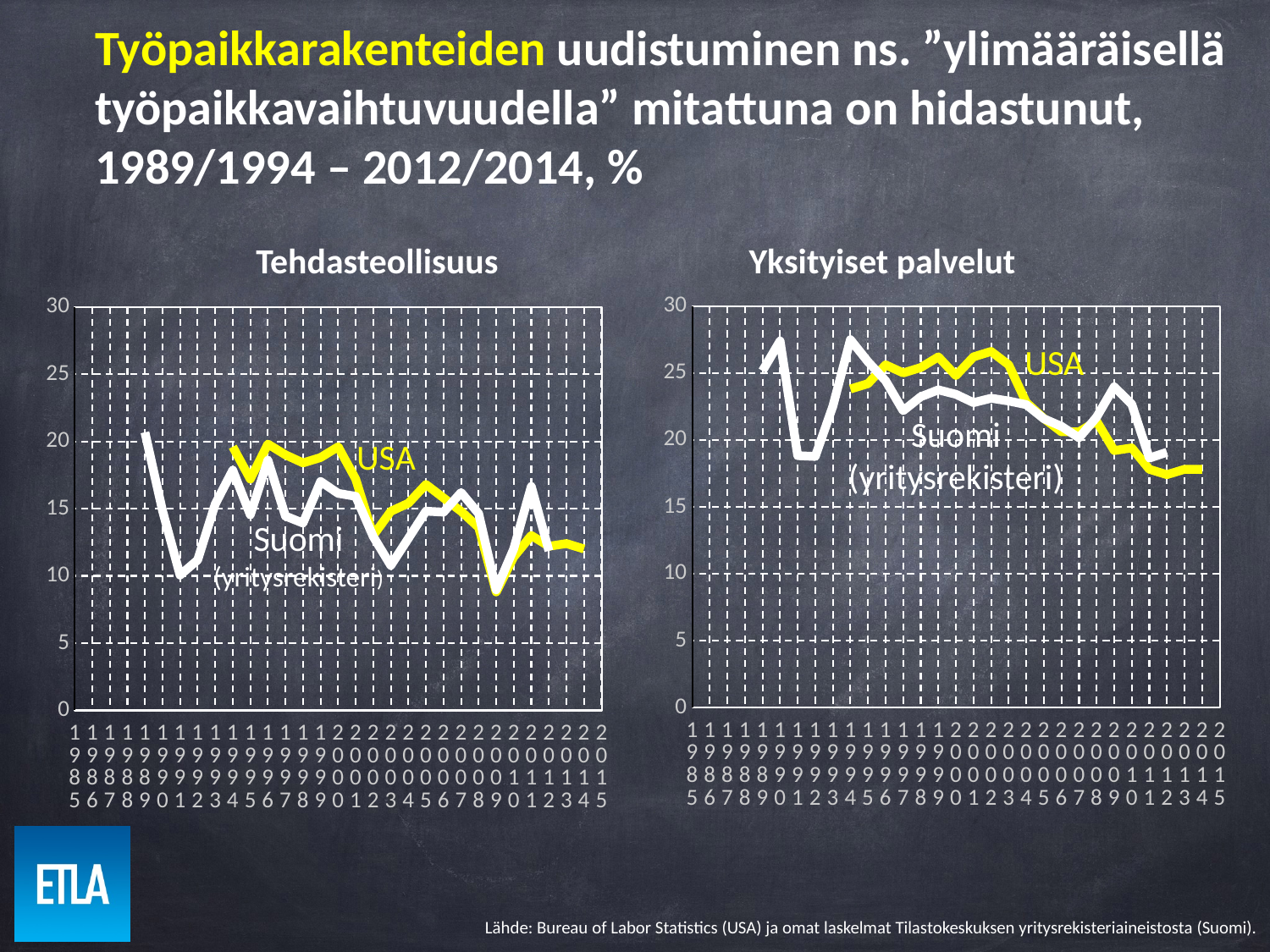
What kind of chart is the Tehdasteollisuus chart? line chart In the Yksityiset palvelut chart, which series is drawn in yellow? USA In the Yksityiset palvelut chart, is the Suomi (yritysrekisteri) value for 2010 greater or less than 20? greater How many series are plotted in the Tehdasteollisuus chart? 2 What kind of chart is the Yksityiset palvelut chart? line chart In the Tehdasteollisuus chart, is the Suomi (yritysrekisteri) value for 2000 greater or less than 20? less In the Yksityiset palvelut chart, does the USA series overall rise or fall from 1995 to 2015? fall In the Tehdasteollisuus chart, which series is drawn in white? Suomi (yritysrekisteri)